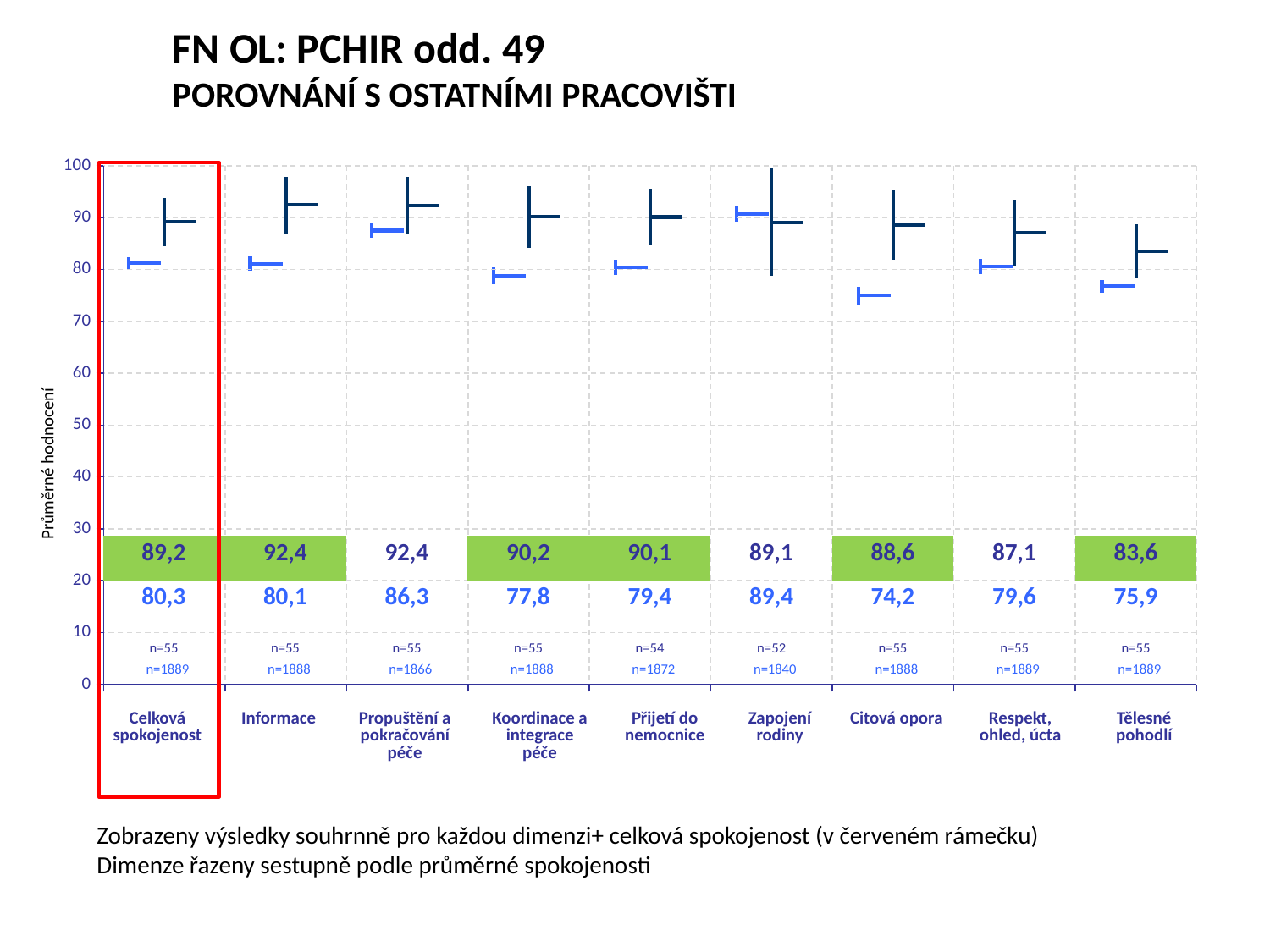
What is the light blue (bottom row) value for Citová opora? 74,2 Which category has the lowest light blue (bottom row) value? Citová opora Which category is highlighted with a red frame? Celková spokojenost What is the difference between the dark navy and light blue values for Propuštění a pokračování péče? 6,1 What is the difference between the dark navy and light blue values for Celková spokojenost? 8,9 What is the dark navy (top row) value for Informace? 92,4 Is the light blue value for Koordinace a integrace péče greater or less than 80? less Which category has the highest light blue (bottom row) value? Zapojení rodiny For Zapojení rodiny, which is larger: the dark navy value or the light blue value? the light blue value (89,4) How many categories are shown on the x axis? 9 What is the first n value shown for Přijetí do nemocnice? n=54 Which category has the lowest dark navy (top row) value? Tělesné pohodlí